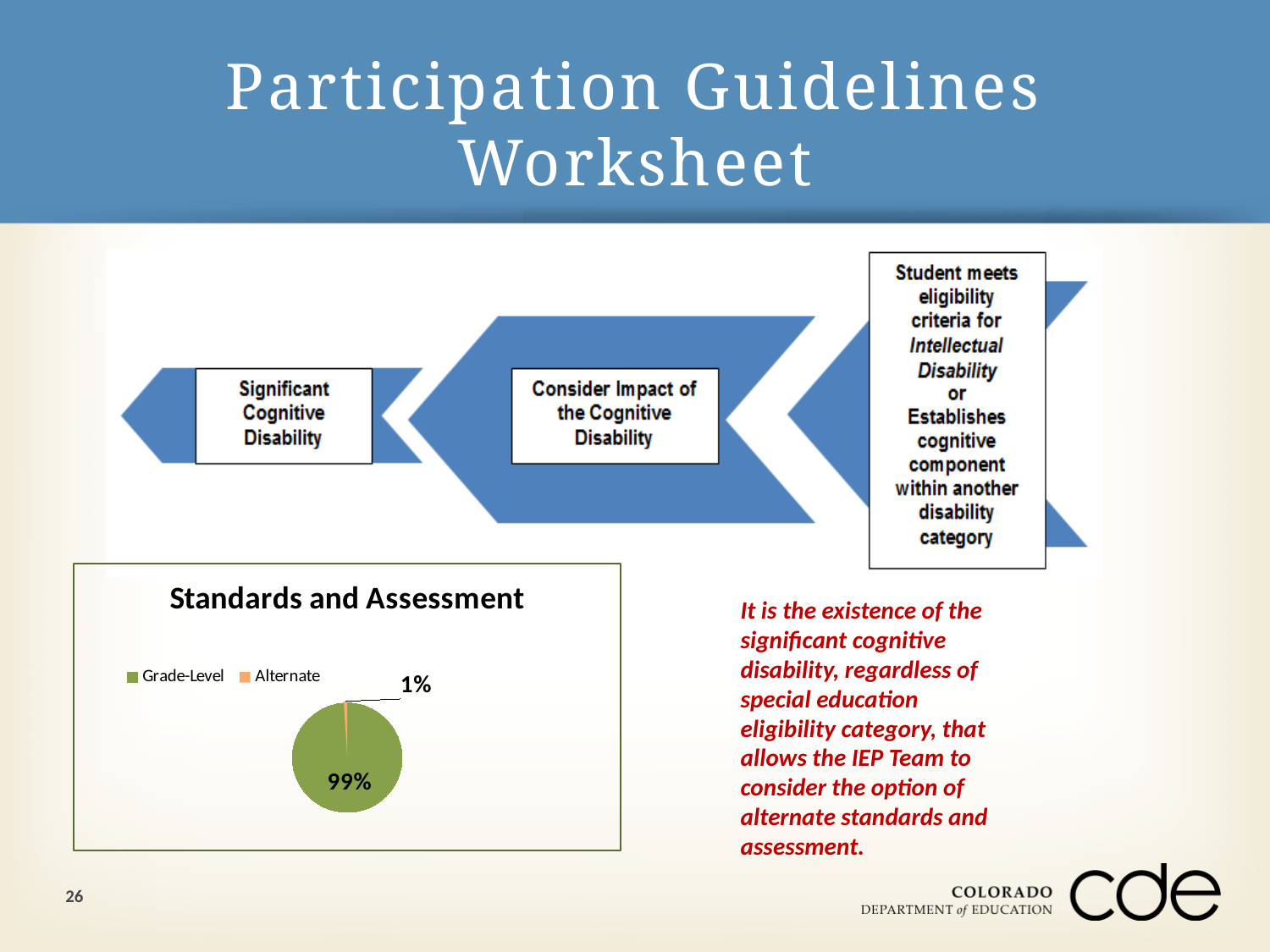
Which category has the largest slice in the pie chart? Grade-Level Which category has the smallest slice in the pie chart? Alternate What is the difference in percentage points between the Grade-Level and Alternate slices? 98 What colour is the Grade-Level slice in the pie chart? green What percentage of the pie chart is Grade-Level? 99% How many categories does the legend of the pie chart list? 2 What is the title of the pie chart on the slide? Standards and Assessment How many slices does the pie chart have? 2 What percentage of the pie chart is Alternate? 1% Which is larger in the pie chart, Grade-Level or Alternate? Grade-Level What kind of chart is shown under the title "Standards and Assessment"? pie chart